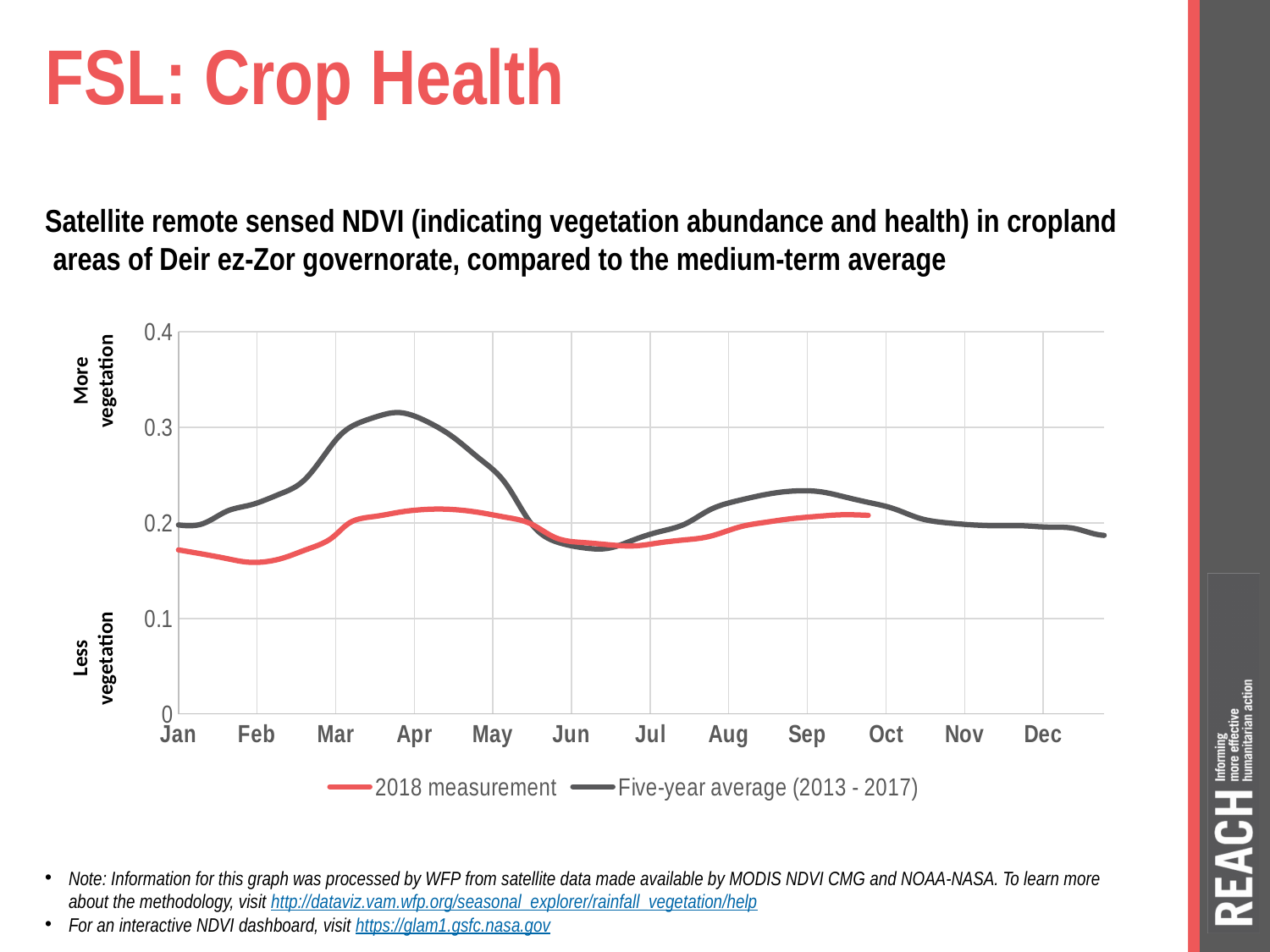
How many series does the legend list? 2 Which series does the red line represent? 2018 measurement In Feb, which series has the higher value: 2018 measurement or five-year average (2013 - 2017)? Five-year average (2013 - 2017) Is the five-year average (2013 - 2017) value in Apr greater or less than 0.3? greater In Apr, which series has the higher value: 2018 measurement or five-year average (2013 - 2017)? Five-year average (2013 - 2017) Is the five-year average (2013 - 2017) value in Jun greater or less than 0.2? less What kind of chart is shown on the slide? Line chart What is the highest value shown on the y axis? 0.4 How many months are labelled along the x axis? 12 Does the 2018 measurement rise or fall between Feb and Apr? Rise Does the five-year average (2013 - 2017) rise or fall between Apr and Jun? Fall Is the 2018 measurement value in Feb greater or less than 0.2? less